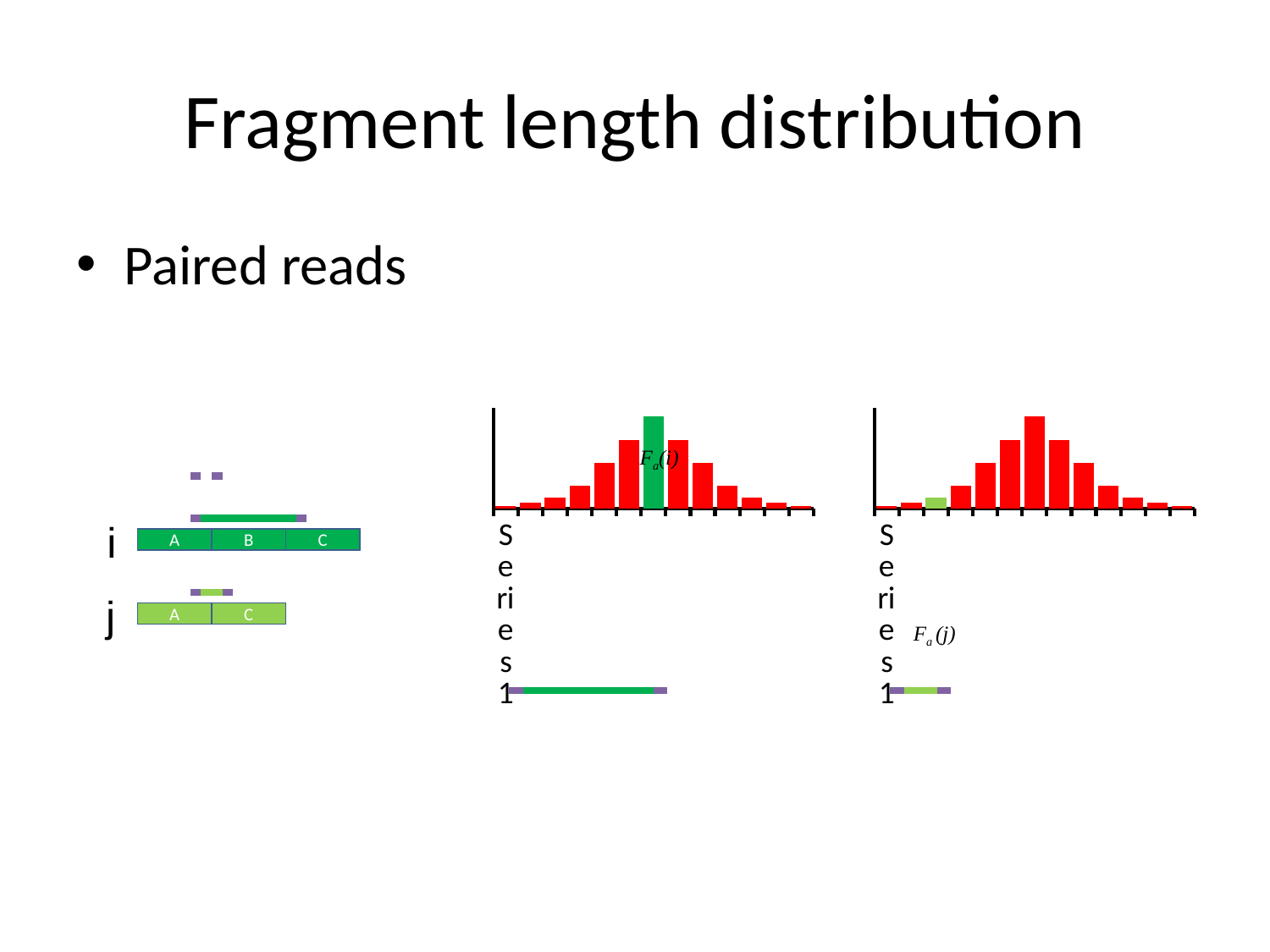
What kind of chart is the left chart on the slide? bar chart What kind of chart is the right chart on the slide? bar chart In the right chart, is the light green highlighted bar taller or shorter than the tallest red bar? shorter In the left chart, what colour is the tallest bar? green In the left chart, do the bars rise or fall moving from the tallest bar toward the right end of the axis? fall What label is printed next to the green bar in the left chart? Fa(i) In the right chart, do the bars rise or fall moving from the left end of the axis toward the tallest bar? rise In the right chart, what colour is the tallest bar? red